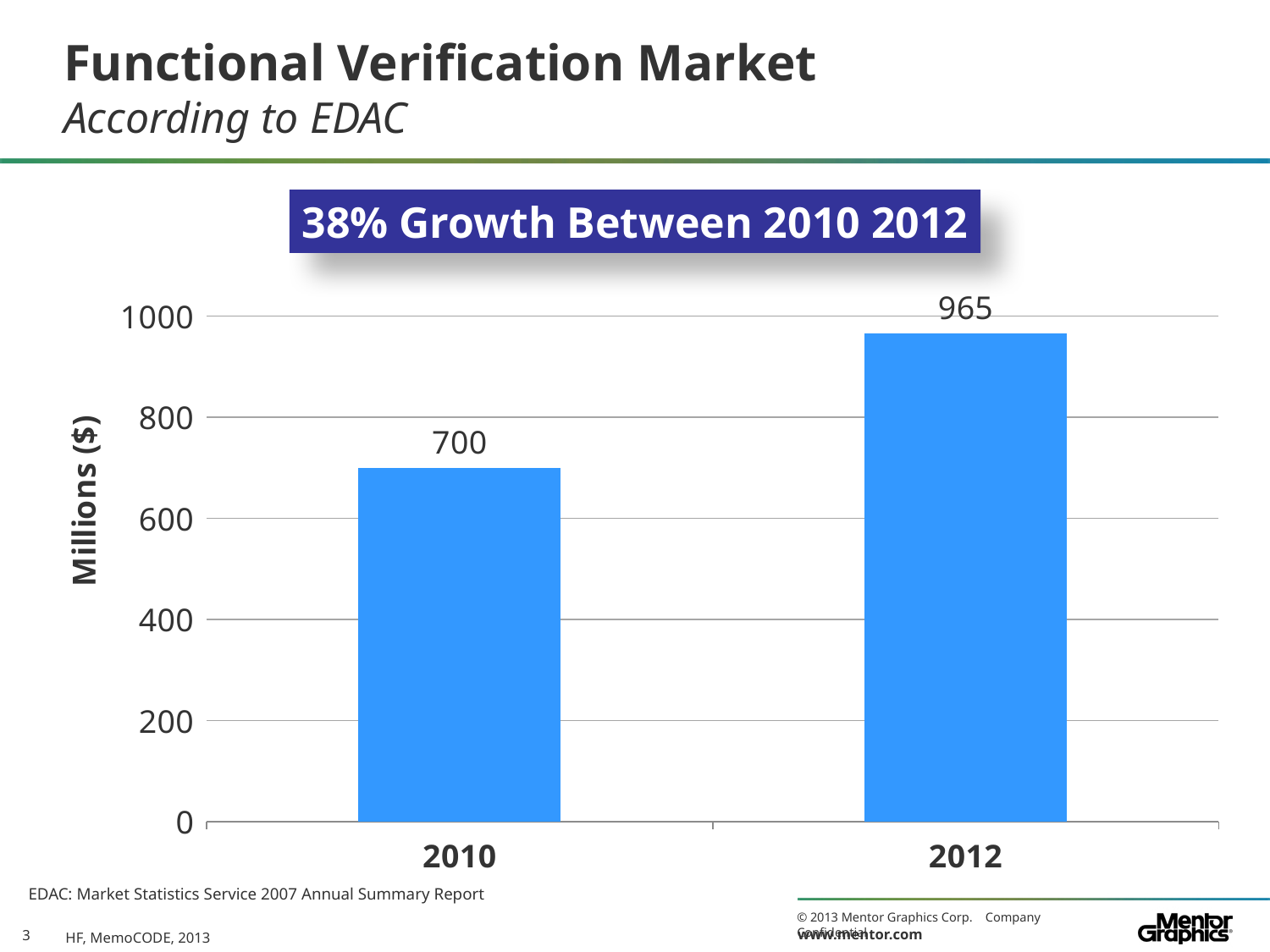
Is the value for 2010 greater or less than 800? less Is the value for 2012 greater or less than 800? greater Which year has the highest value? 2012 What is the value for 2010? 700 Do the values rise or fall from 2010 to 2012? rise Which is larger, the value for 2010 or the value for 2012? 2012 Which year has the lowest value? 2010 What kind of chart is shown on the slide? bar chart What is the label of the y axis? Millions ($) How many bars are shown in the chart? 2 What is the value for 2012? 965 What is the difference between the values for 2012 and 2010? 265